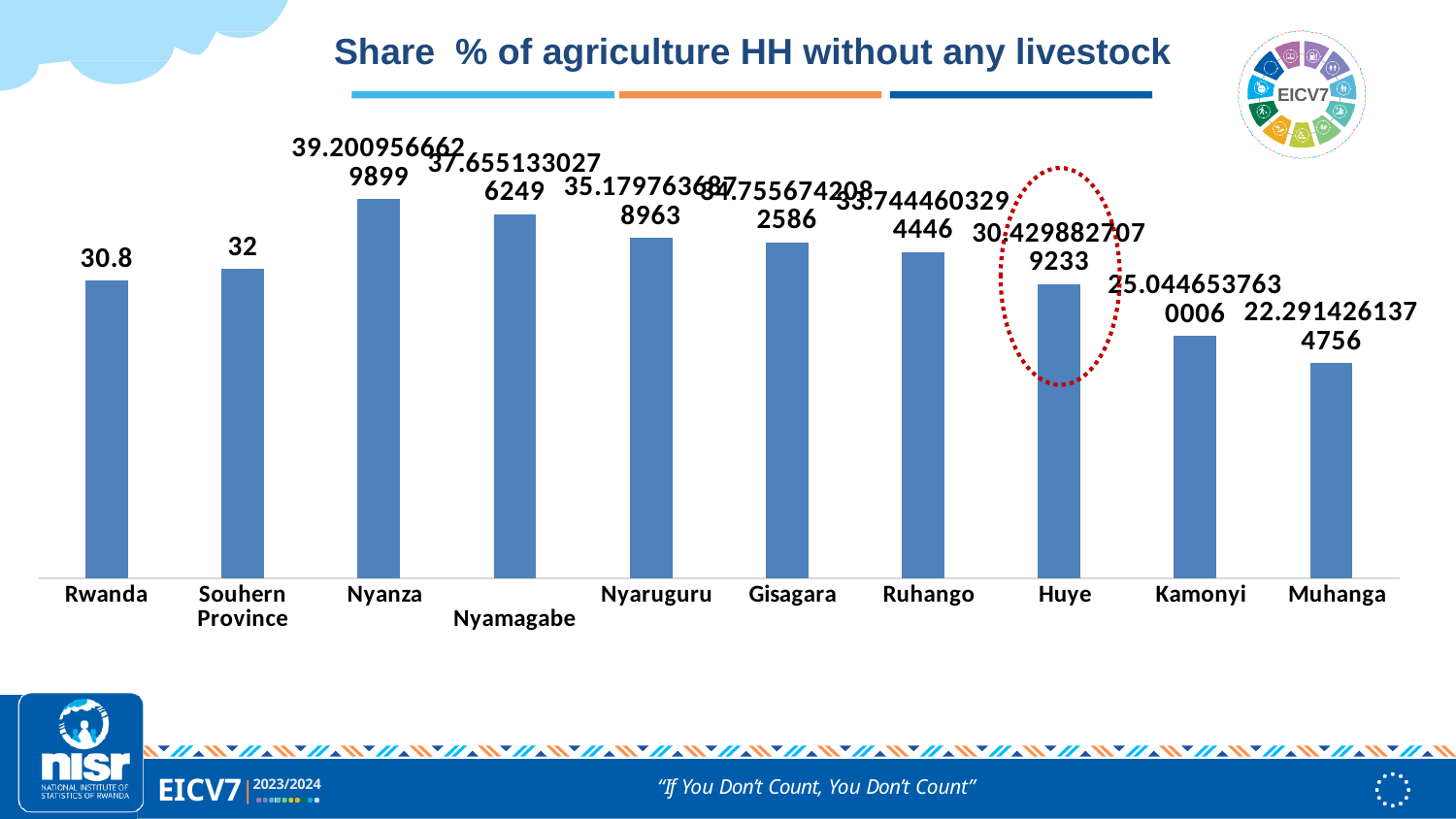
Which district has the highest share of agriculture households without any livestock? Nyanza Which category has the lowest value on the chart? Muhanga What is the title of the chart? Share % of agriculture HH without any livestock Which is larger, the value for Nyanza or the value for Muhanga? Nyanza What is the difference between the values for Souhern Province and Rwanda? 1.2 What kind of chart is shown on the slide? Bar chart Which is larger, the value for Rwanda or the value for Souhern Province? Souhern Province Which district's bar is highlighted with a red dotted circle? Huye What is the value for Rwanda? 30.8 How many categories are shown on the x axis? 10 Do the values rise or fall from Nyanza to Muhanga along the x axis? Fall What is the value for Souhern Province? 32